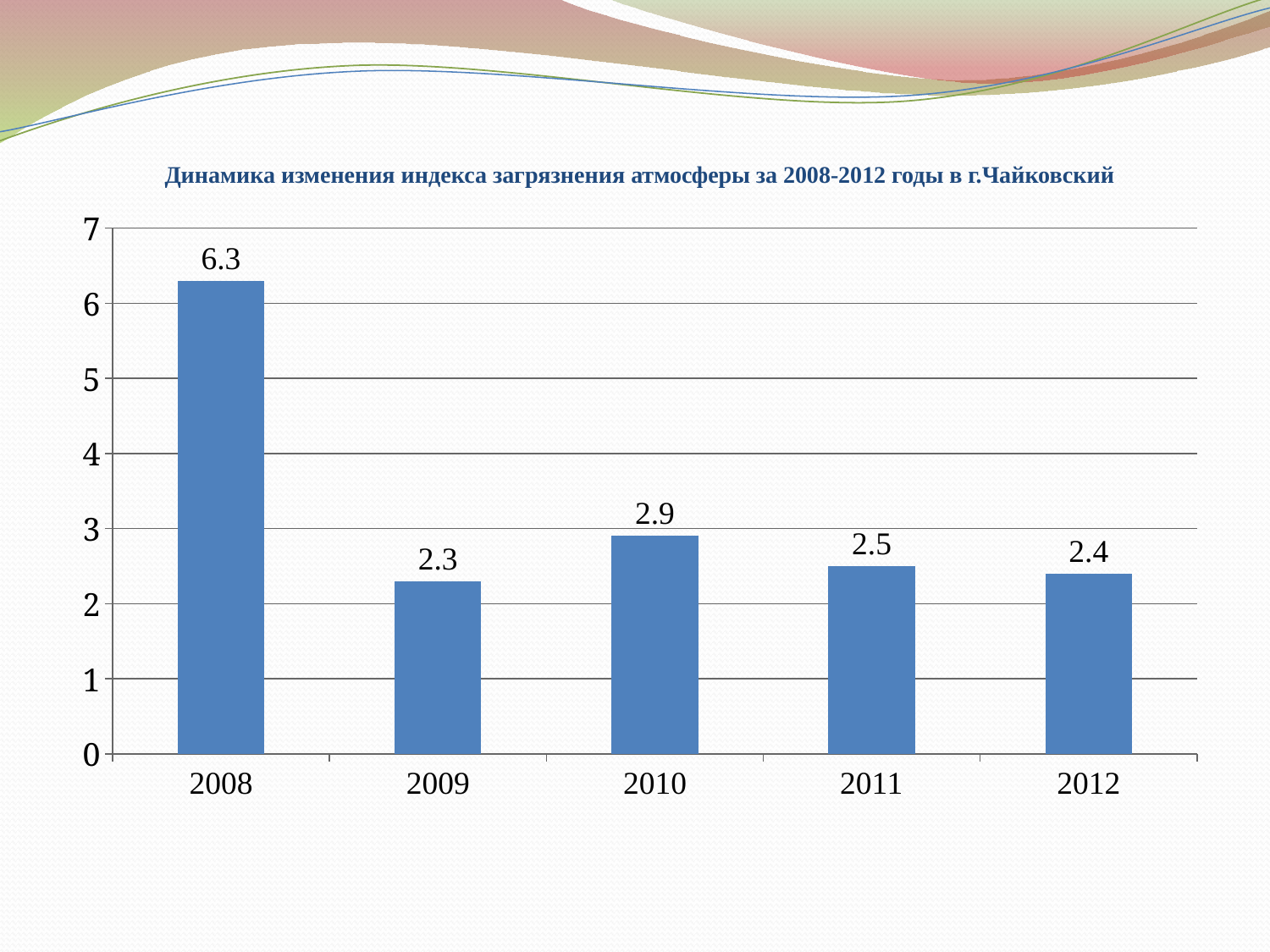
Which year has the lowest value? 2009 What is the difference between the values for 2008 and 2009? 4 Does the value rise or fall from 2008 to 2009? fall What is the difference between the values for 2010 and 2011? 0.4 What is the value shown for 2012? 2.4 What kind of chart is shown on the slide? bar chart Which year has the highest value? 2008 How many years are shown on the x axis? 5 What is the value shown for 2010? 2.9 What is the atmospheric pollution index value for 2008? 6.3 Is the value for 2011 greater or less than 3? less Which is larger, the value for 2010 or the value for 2012? 2010